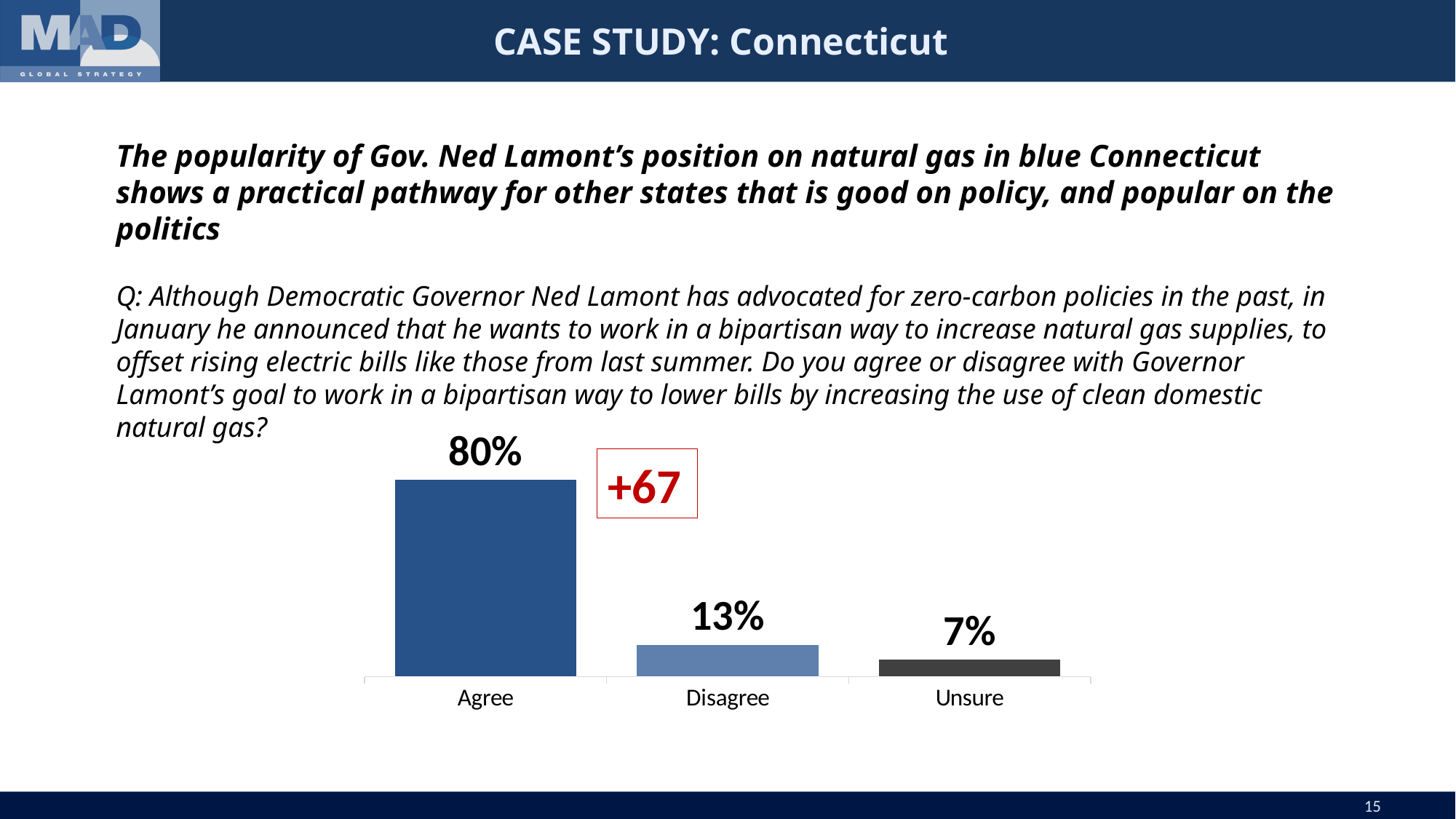
What percentage of respondents agree with Governor Lamont's goal? 80% What kind of chart is shown on the slide? Bar chart What percentage of respondents are unsure? 7% Which response category has the lowest value? Unsure What is the combined percentage of Agree and Disagree responses? 93% What percentage of respondents disagree? 13% What is the difference between the Agree and Disagree percentages? 67 percentage points What net figure is shown in the red box next to the Agree bar? +67 What is the difference between the Disagree and Unsure percentages? 6 percentage points Which is larger, the Disagree value or the Unsure value? Disagree How many response categories are shown in the chart? 3 Which response category has the highest value? Agree